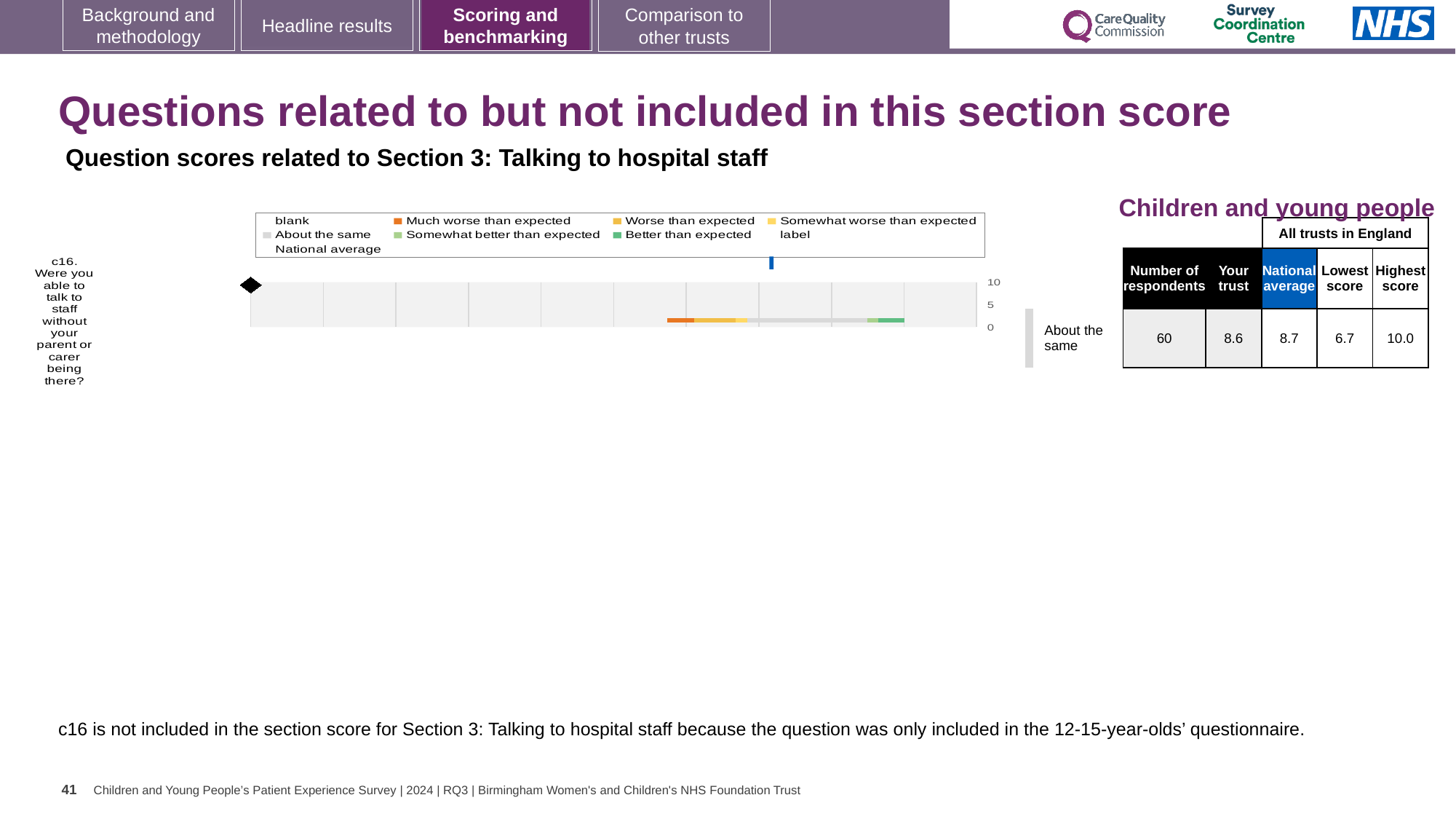
How many respondents answered c16? 60 Which is larger for c16, the trust's score or the national average? national average What is the 'Your trust' score for c16? 8.6 What is the highest tick value shown on the chart's score axis? 10 Which question is plotted in the chart? c16. Were you able to talk to staff without your parent or carer being there? What is the highest score among all trusts in England for c16? 10.0 What kind of chart is shown on the slide for question c16? bar chart How many questions (categories) are plotted in the chart? 1 What is the difference between the highest and lowest scores for c16 across all trusts in England? 3.3 What is the lowest score among all trusts in England for c16? 6.7 What is the national average score for c16? 8.7 How many entries does the chart legend list? 9